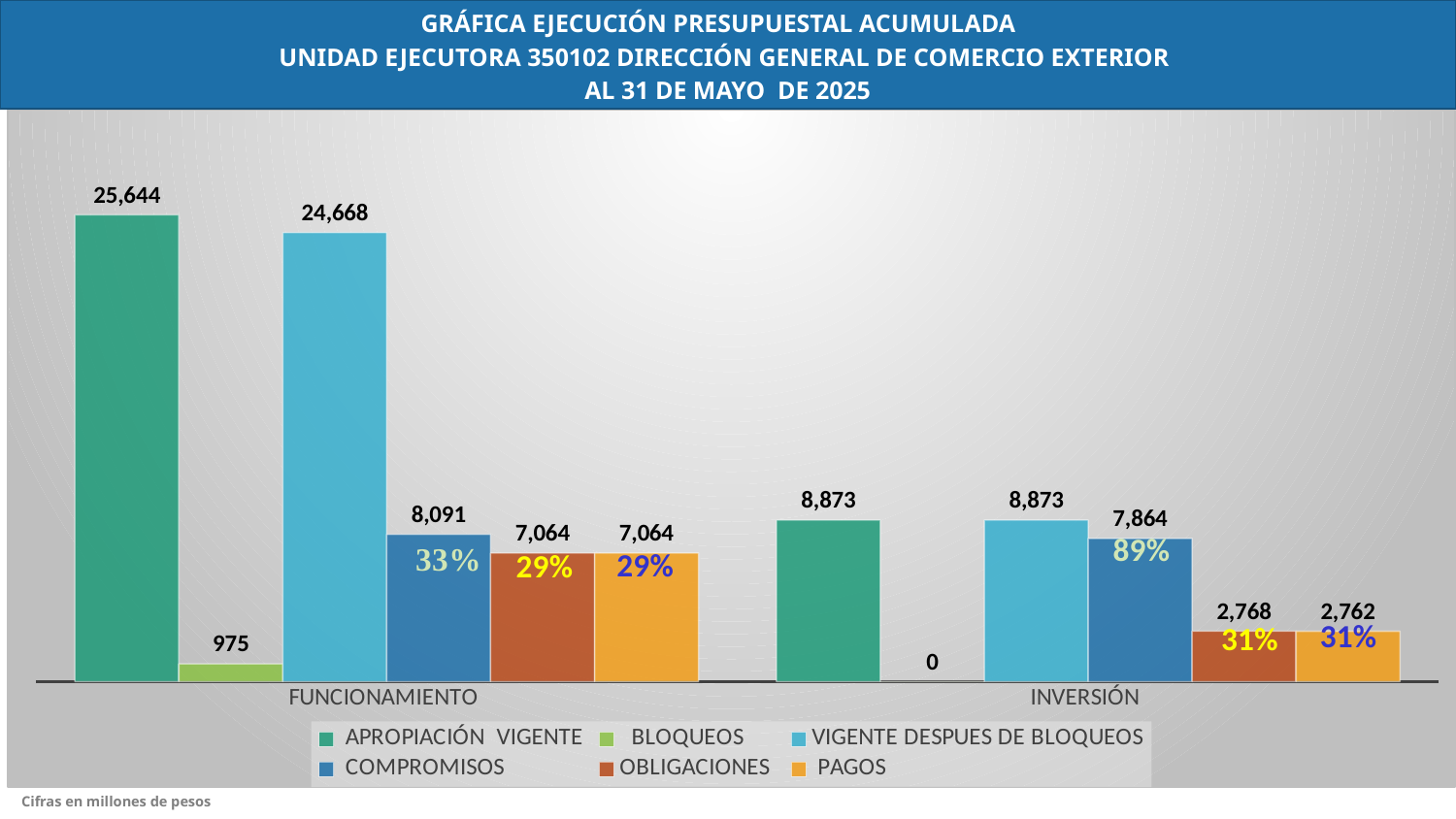
How many series does the legend list? 6 How many categories are shown on the x axis? 2 Which series has the lowest value for INVERSIÓN? BLOQUEOS Which series has the highest value for FUNCIONAMIENTO? APROPIACIÓN VIGENTE What is the difference between OBLIGACIONES and PAGOS for INVERSIÓN? 6 What is the difference between APROPIACIÓN VIGENTE and VIGENTE DESPUES DE BLOQUEOS for FUNCIONAMIENTO? 976 What kind of chart is shown on the slide? Bar chart What is the value of COMPROMISOS for INVERSIÓN? 7,864 What is the value of BLOQUEOS for INVERSIÓN? 0 What is the value of PAGOS for FUNCIONAMIENTO? 7,064 Which is larger: COMPROMISOS for FUNCIONAMIENTO or COMPROMISOS for INVERSIÓN? COMPROMISOS for FUNCIONAMIENTO What is the value of APROPIACIÓN VIGENTE for FUNCIONAMIENTO? 25,644